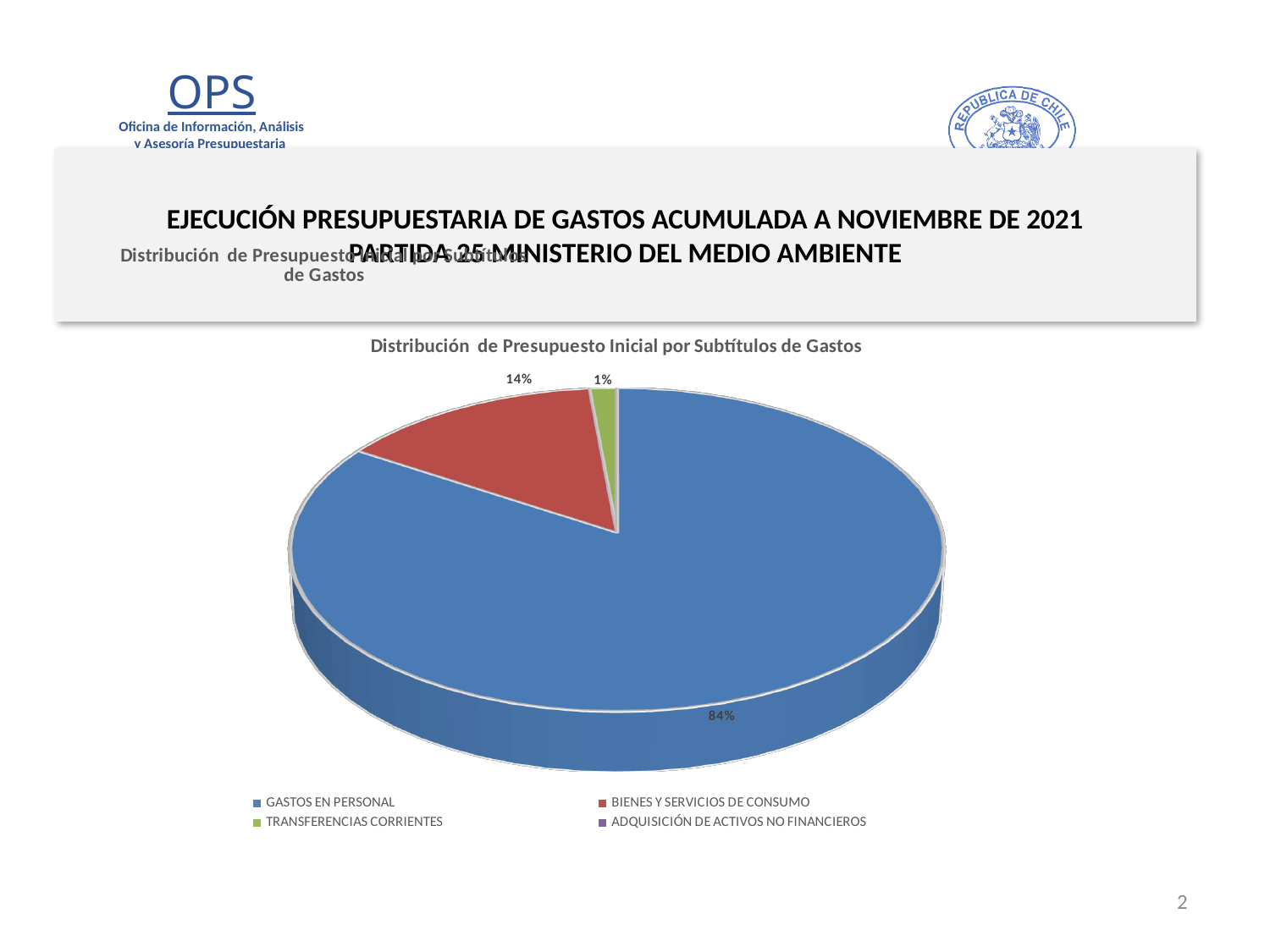
Is the share for BIENES Y SERVICIOS DE CONSUMO greater or less than 50%? less What percentage is shown for TRANSFERENCIAS CORRIENTES? 1% What share of the pie does GASTOS EN PERSONAL represent? 84% What is the difference in percentage points between GASTOS EN PERSONAL and BIENES Y SERVICIOS DE CONSUMO? 70 percentage points How many categories does the legend list? 4 Which category has the largest slice of the pie? GASTOS EN PERSONAL What is the title of the chart? Distribución de Presupuesto Inicial por Subtítulos de Gastos Which is larger, the slice for BIENES Y SERVICIOS DE CONSUMO or the slice for TRANSFERENCIAS CORRIENTES? BIENES Y SERVICIOS DE CONSUMO What kind of chart is shown on the slide? Pie chart What percentage is shown for BIENES Y SERVICIOS DE CONSUMO? 14% What colour is the slice for GASTOS EN PERSONAL? Blue